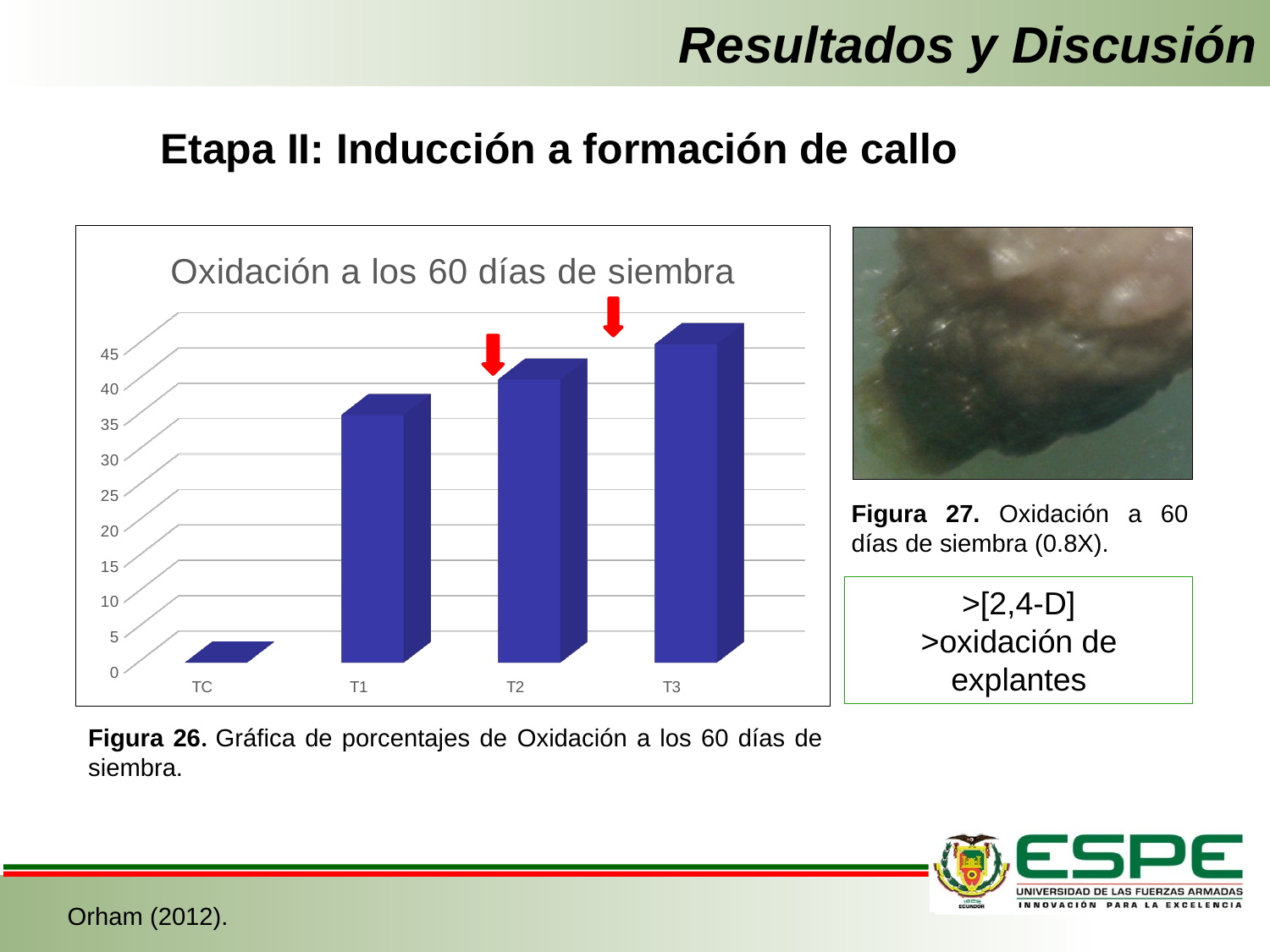
What kind of chart is shown on the slide? bar chart What is the title of the chart? Oxidación a los 60 días de siembra Which category has the lowest value in the chart? TC Is the value for T3 greater or less than 40? greater Which two bars have red arrows pointing at them? T2 and T3 Is the value for T2 greater or less than 45? less How many categories are shown on the x axis of the chart? 4 Is the value for T1 greater or less than 30? greater Which category has the highest value in the chart? T3 Which has a larger value, T1 or T3? T3 Which has a larger value, T1 or T2? T2 Do the values rise or fall from TC to T3 along the x axis? rise